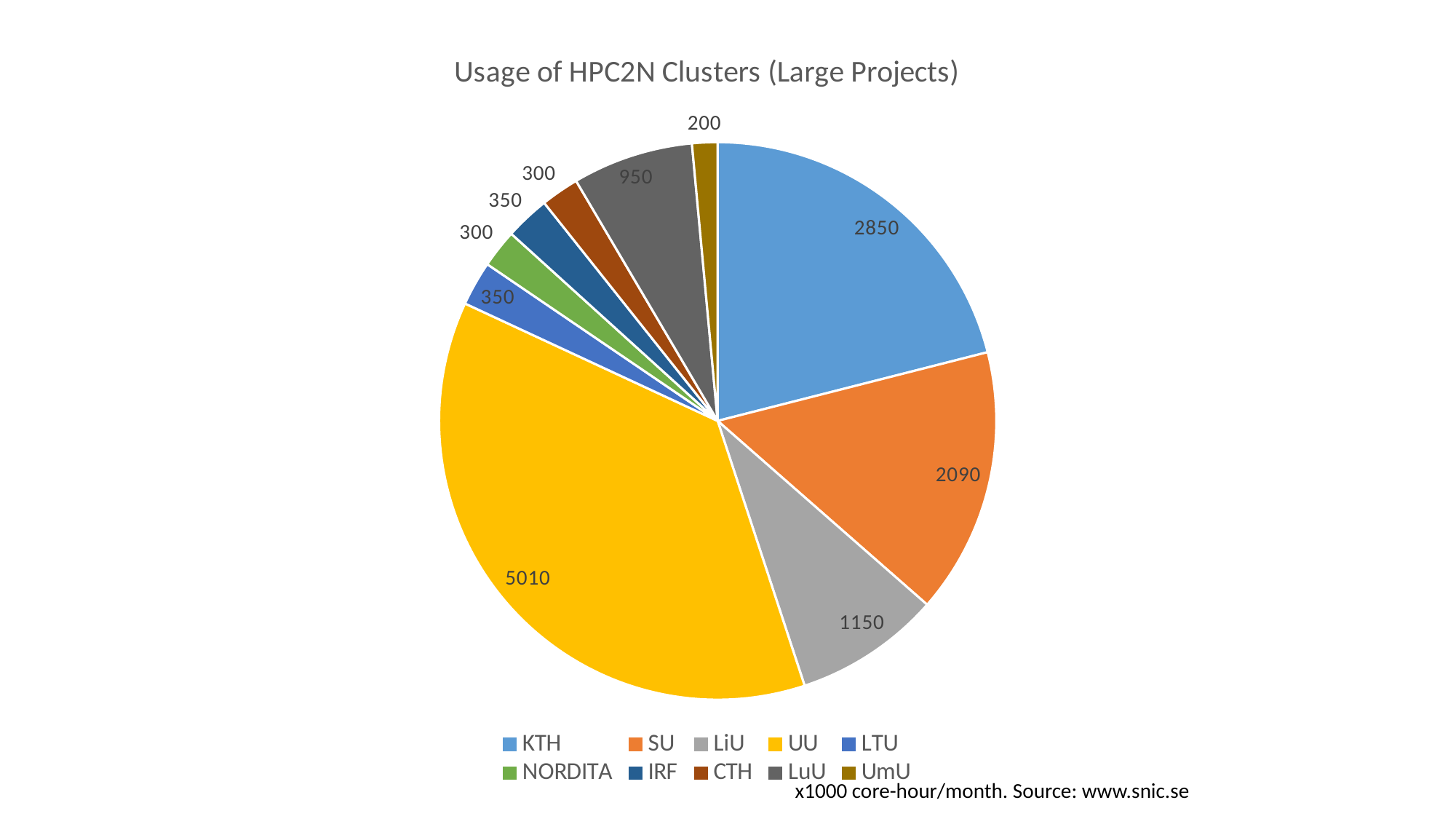
What type of chart is shown on the slide? pie chart What is the value for UU? 5010 What is the value for KTH? 2850 What is the title of the chart? Usage of HPC2N Clusters (Large Projects) What share of the pie does UU represent, to the nearest percent? 37% Which category has the smallest slice? UmU How many categories does the pie chart have? 10 What is the total of all slices in the pie chart? 13550 Which category has the largest slice? UU What is the difference between the values for KTH and SU? 760 What is the value for LuU? 950 Which is larger, the value for SU or the value for LiU? SU